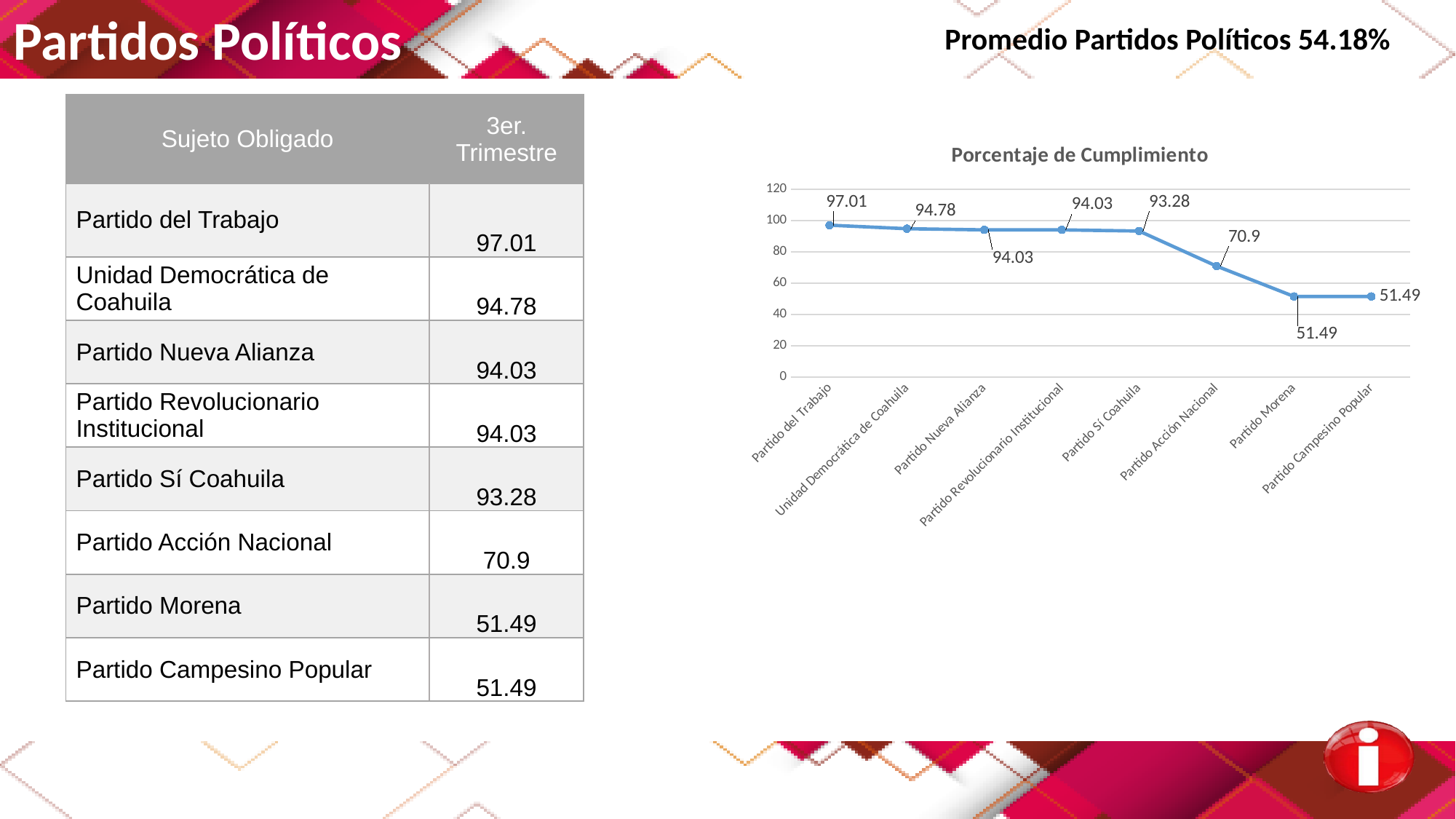
What is the value for Partido del Trabajo in the Porcentaje de Cumplimiento chart? 97.01 What is the value for Partido Sí Coahuila in the chart? 93.28 What kind of chart is shown on the slide? line chart What is the difference between the values for Partido del Trabajo and Partido Morena? 45.52 What is the value for Unidad Democrática de Coahuila in the chart? 94.78 Which category has the highest value in the chart? Partido del Trabajo Do the values rise or fall from left to right along the x axis? fall How many categories are plotted in the chart? 8 What is the value for Partido Acción Nacional in the chart? 70.9 Is the value for Partido Morena greater or less than 60? less Which is larger, the value for Partido Sí Coahuila or the value for Partido Acción Nacional? Partido Sí Coahuila What is the difference between the values for Partido Acción Nacional and Partido Campesino Popular? 19.41